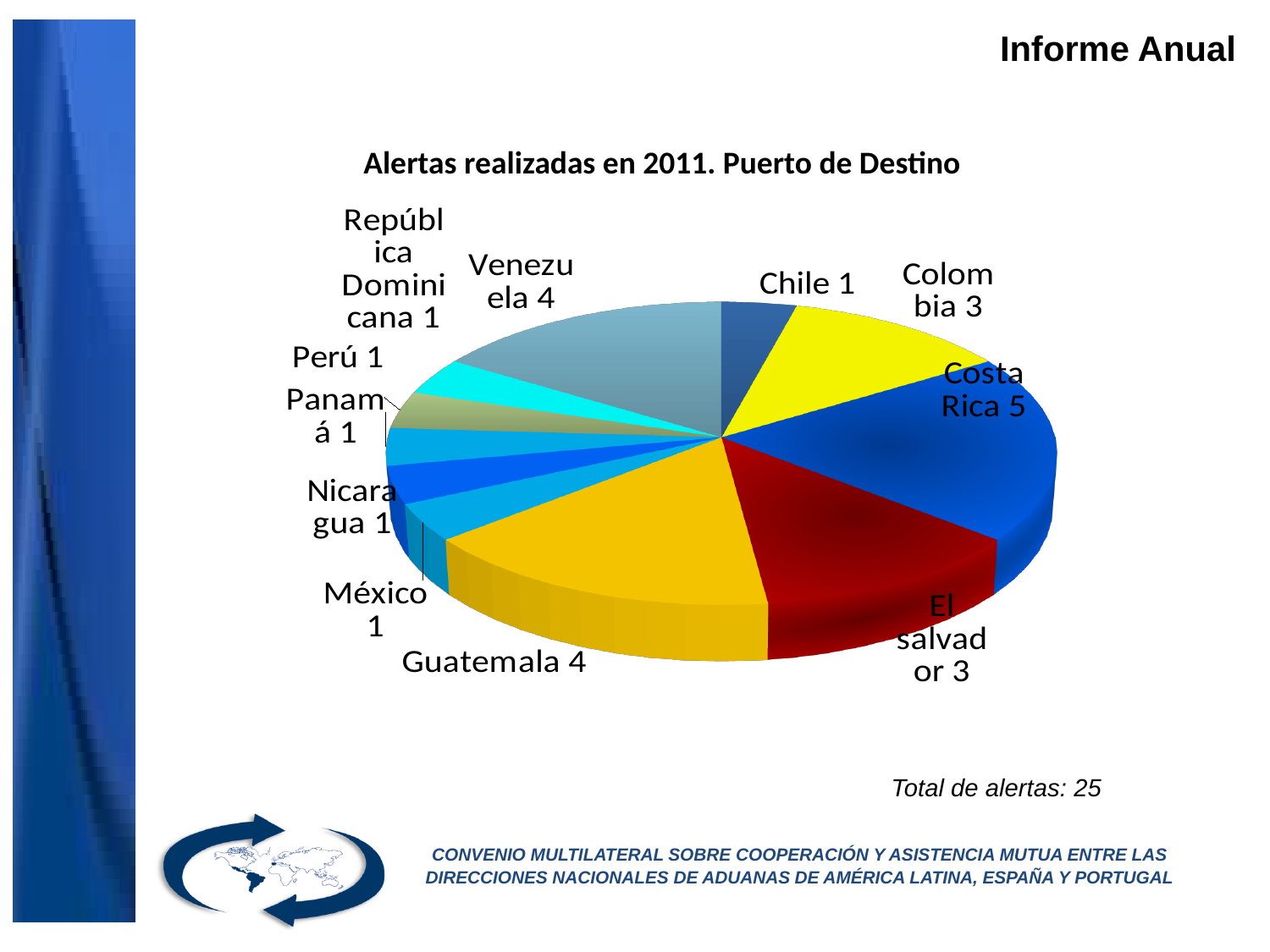
How many alerts are shown for Colombia? 3 What is the total number of alerts shown on the slide? 25 What type of chart is shown on the slide? Pie chart How many alerts are shown for Costa Rica? 5 What is the title of the chart? Alertas realizadas en 2011. Puerto de Destino How many alerts are shown for Guatemala? 4 How many countries (slices) are shown in the pie chart? 11 How many alerts are shown for Venezuela? 4 What share of the total alerts does Costa Rica represent? 20% Which has more alerts, Costa Rica or Guatemala? Costa Rica What is the difference between the number of alerts for Costa Rica and for Colombia? 2 Which country has the largest slice of the pie? Costa Rica